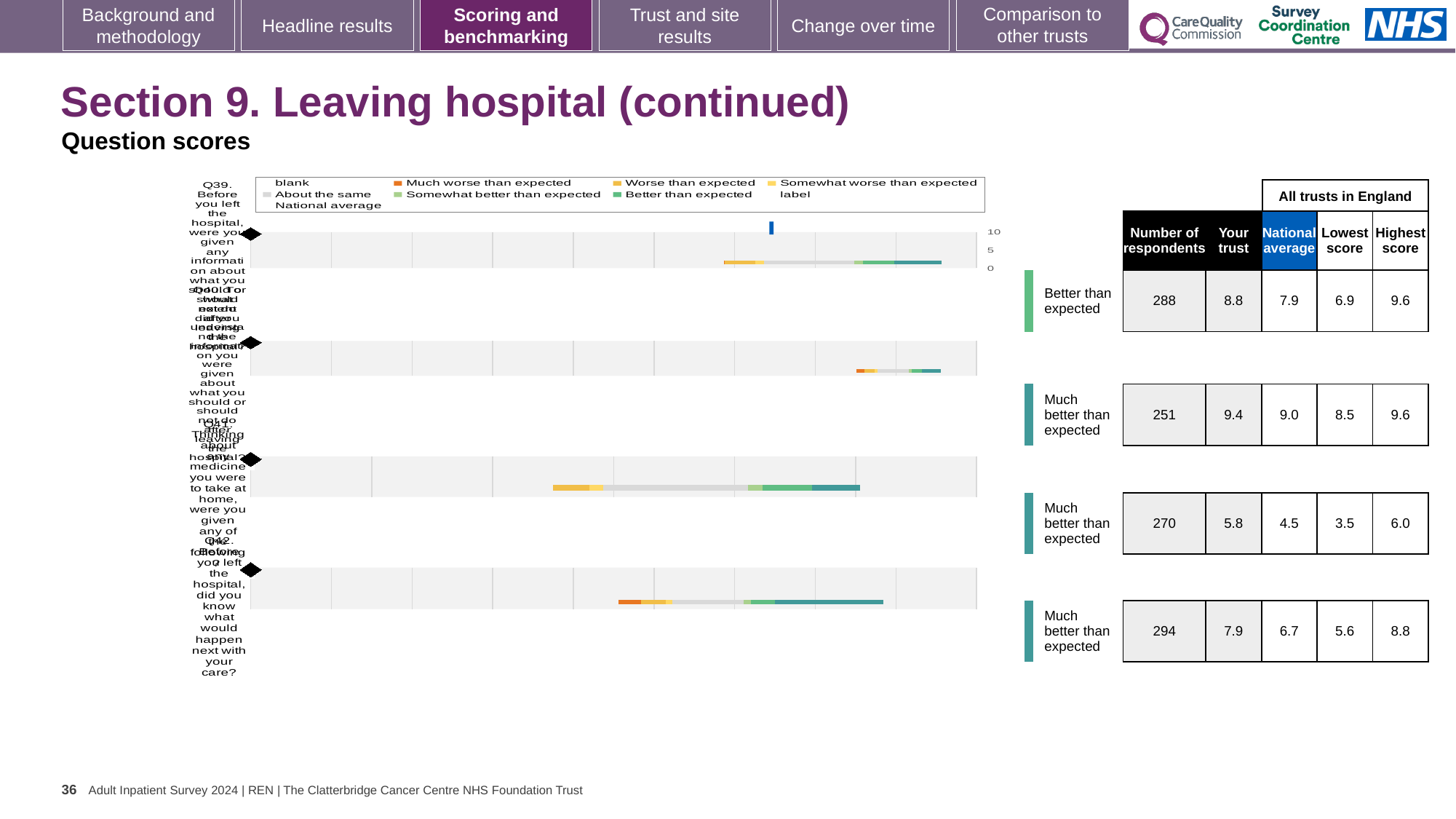
What rating label is printed beside the first (top) chart, Q39? Better than expected For the fourth chart (Q42, what would happen next with your care), what is the national average score? 6.7 How many question charts are shown on the slide? 4 Which of the four charts has the lowest 'Your trust' score? the third chart (5.8) For the third chart (Q41, medicine to take at home), what is the 'Your trust' score? 5.8 Which of the four charts has the highest 'Your trust' score? the second chart (9.4) In the chart legend, which category is shown in orange? Much worse than expected For the first chart (Q39), what is the number of respondents shown in the table? 288 For the fourth chart (Q42), which is larger: the 'Your trust' score or the national average? Your trust What kind of chart is used to show the question scores on this slide? bar chart For the first chart (Q39), what is the difference between the 'Your trust' score and the national average? 0.9 Is the 'Your trust' score for the first chart (Q39) greater or less than 5 on the axis? greater